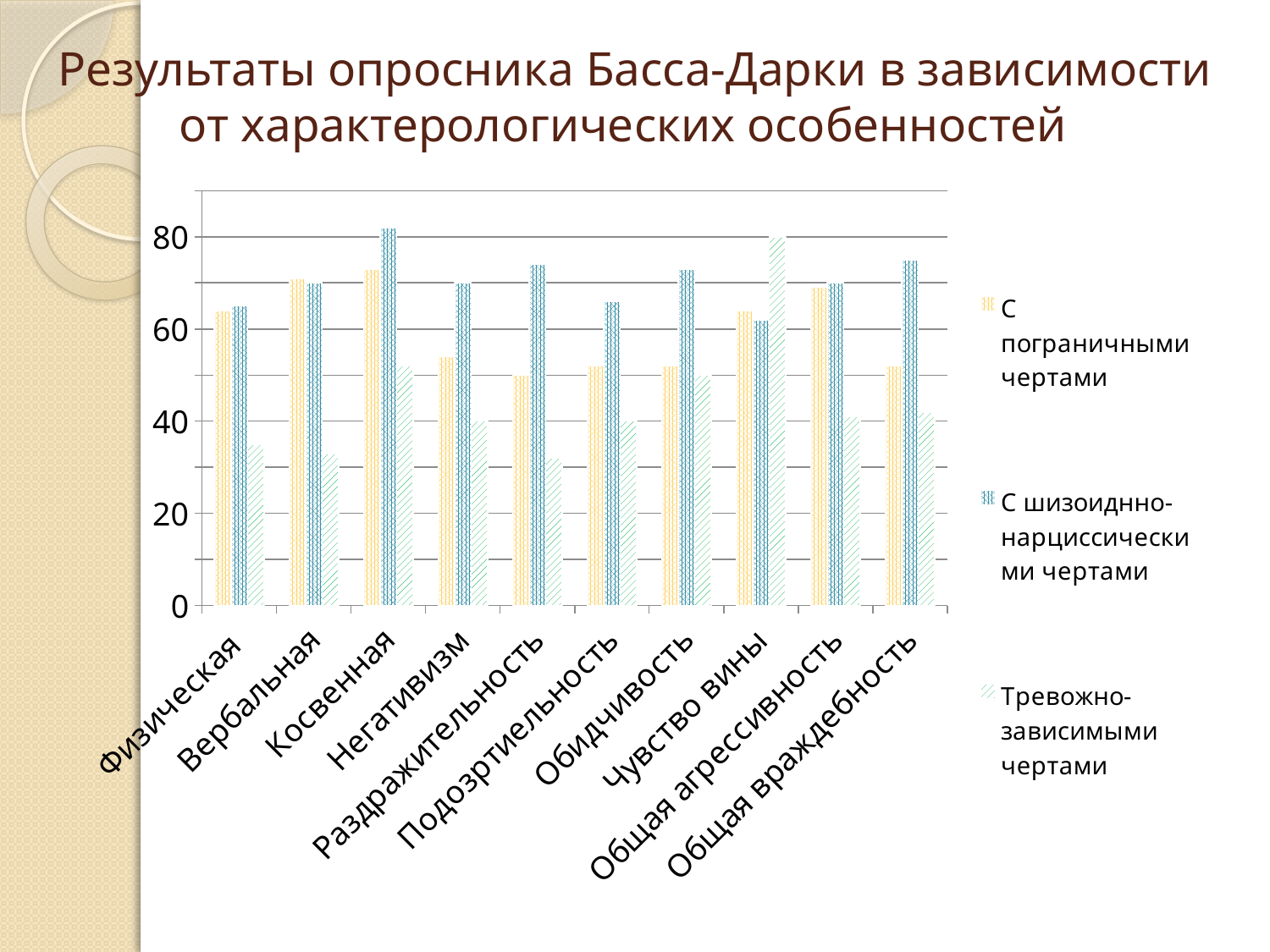
Is the value for "Физическая" in the series "Тревожно-зависимыми чертами" greater or less than 40? less For "Раздражительность", which series has the larger value: "С шизоиднно-нарциссическими чертами" or "Тревожно-зависимыми чертами"? С шизоиднно-нарциссическими чертами For "Чувство вины", which series has the larger value: "С пограничными чертами" or "Тревожно-зависимыми чертами"? Тревожно-зависимыми чертами How many categories are shown on the x axis of the chart? 10 For which category is the value of the series "Тревожно-зависимыми чертами" highest? Чувство вины Is the value for "Косвенная" in the series "С шизоиднно-нарциссическими чертами" greater or less than 60? greater Is the value for "Раздражительность" in the series "С пограничными чертами" greater or less than 60? less What is the title of the slide containing the chart? Результаты опросника Басса-Дарки в зависимости от характерологических особенностей What kind of chart is shown on the slide? bar chart How many series does the legend list? 3 For which category is the value of the series "С шизоиднно-нарциссическими чертами" highest? Косвенная